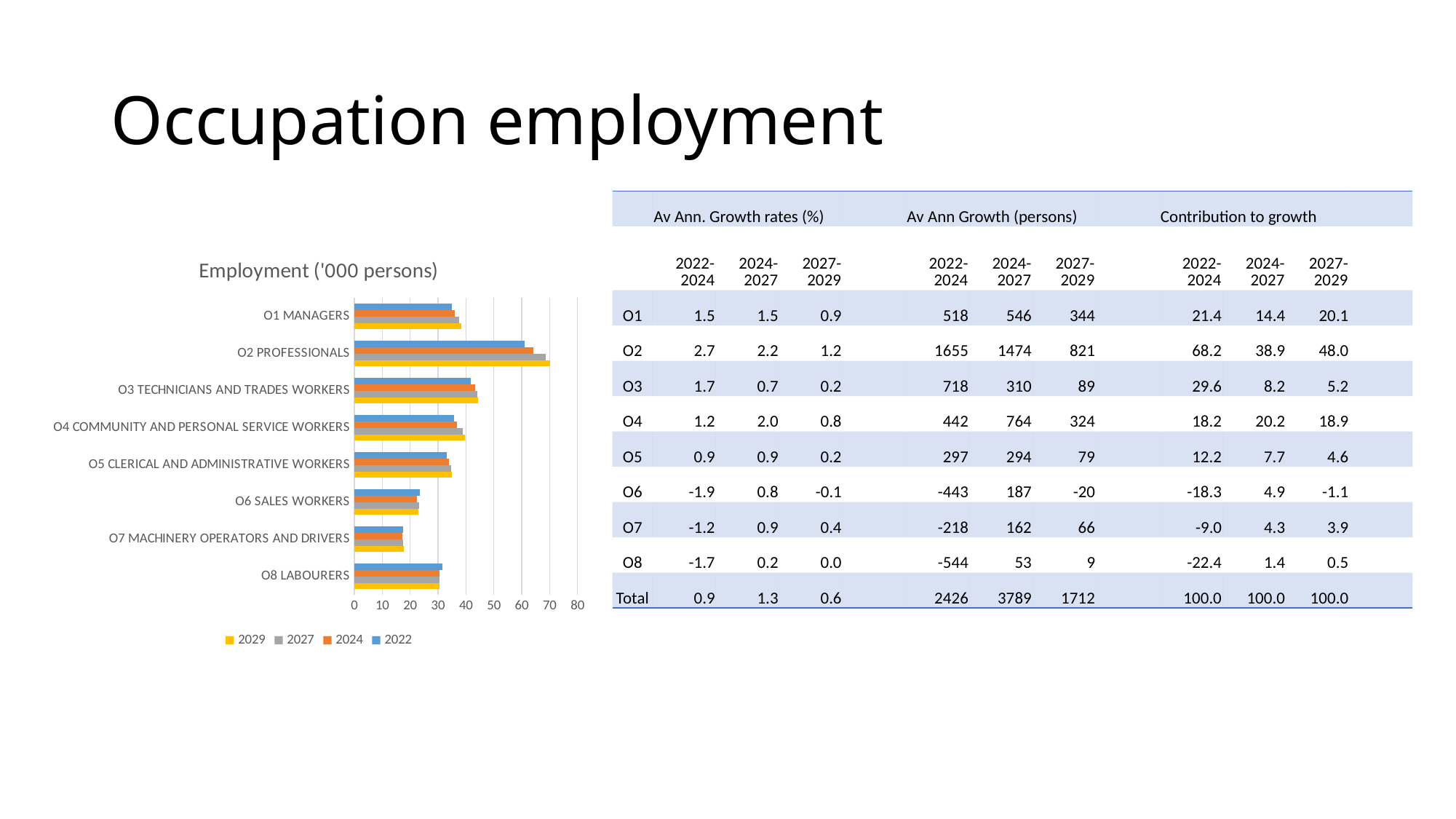
How many occupation categories does the chart show? 8 Which years are listed in the chart's legend? 2029, 2027, 2024, 2022 Is the 2022 value for O1 Managers greater or less than 40? less Which occupation category has the highest employment in the chart? O2 Professionals How many series does the chart's legend list? 4 Which has the larger 2022 employment, O6 Sales workers or O8 Labourers? O8 Labourers What is the title of the chart? Employment ('000 persons) What kind of chart is shown on the slide? Bar chart Is the 2022 value for O8 Labourers greater or less than 20? greater Is the 2029 value for O2 Professionals greater or less than 60? greater Which occupation category has the lowest employment in the chart? O7 Machinery operators and drivers